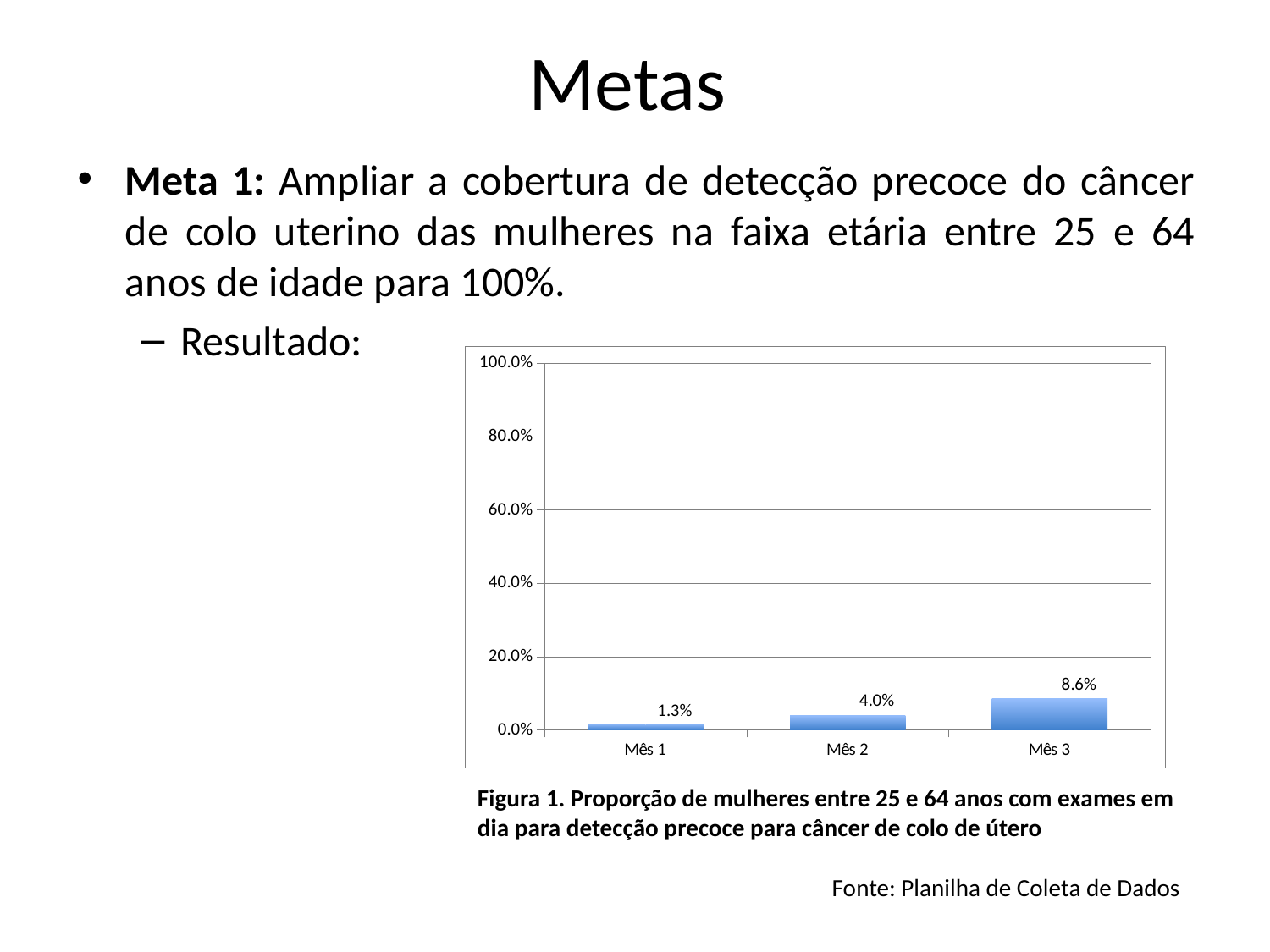
What is the difference between the values for Mês 3 and Mês 1? 7.3% What is the value for Mês 3? 8.6% What kind of chart is shown on the slide? bar chart What is the value for Mês 1? 1.3% What is the value for Mês 2? 4.0% Is the value for Mês 3 greater or less than 20.0%? less What is the difference between the values for Mês 2 and Mês 1? 2.7% Do the values rise or fall from Mês 1 to Mês 3? rise Which is larger, the value for Mês 2 or the value for Mês 3? Mês 3 Which month has the lowest value? Mês 1 Which month has the highest value? Mês 3 How many months are shown on the x axis? 3